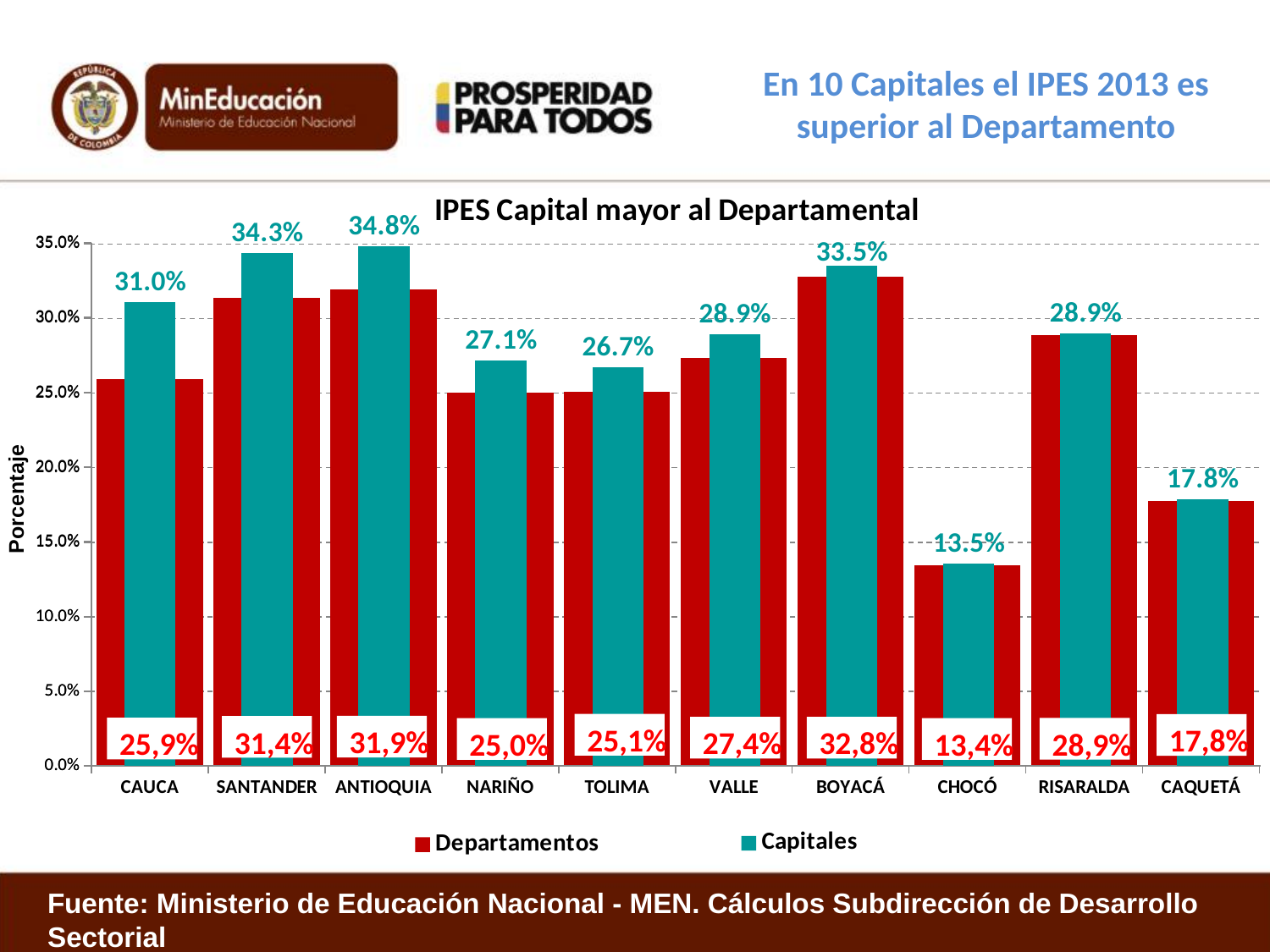
Which is larger for NARIÑO: the Departamentos value or the Capitales value? Capitales How many series does the legend list? 2 What kind of chart is shown on the slide? Bar chart What is the Capitales value for CHOCÓ? 13.5% What is the Departamentos value for BOYACÁ? 32,8% What is the Capitales value for CAUCA? 31.0% How many categories (departments) are shown on the x axis? 10 What is the title of the chart? IPES Capital mayor al Departamental What is the Departamentos value for SANTANDER? 31,4% Which category has the lowest Departamentos value? CHOCÓ Which category has the highest Capitales value? ANTIOQUIA What is the difference between the Capitales and Departamentos values for CAUCA? 5.1 percentage points